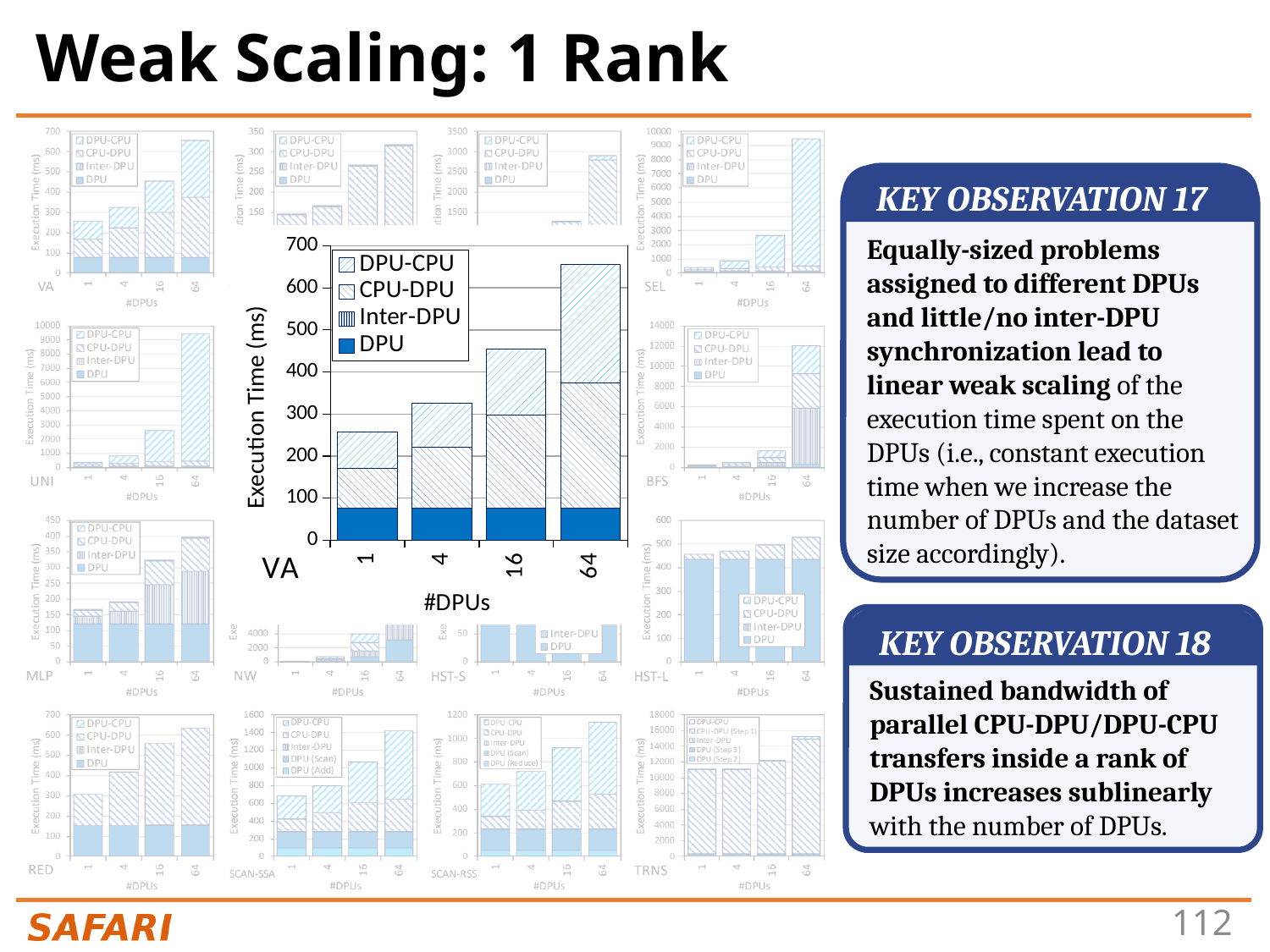
On the enlarged VA chart, which #DPUs value has the tallest stacked bar? 64 On the enlarged VA chart, what kind of chart is shown? bar chart On the enlarged VA chart, how many series does the legend list? 4 On the enlarged VA chart, is the total execution time for 16 DPUs greater or less than 400? greater On the enlarged VA chart, is the total execution time for 1 DPU greater or less than 300? less On the enlarged VA chart, is the DPU segment for 1 DPU greater or less than 100? less On the enlarged VA chart, which #DPUs value has the shortest stacked bar? 1 On the enlarged VA chart, what is the label of the y axis? Execution Time (ms) On the enlarged VA chart, how many #DPUs categories are plotted on the x axis? 4 On the enlarged VA chart, which has the larger total execution time, 16 DPUs or 64 DPUs? 64 DPUs On the enlarged VA chart, does the total execution time rise or fall as the number of DPUs increases? rise